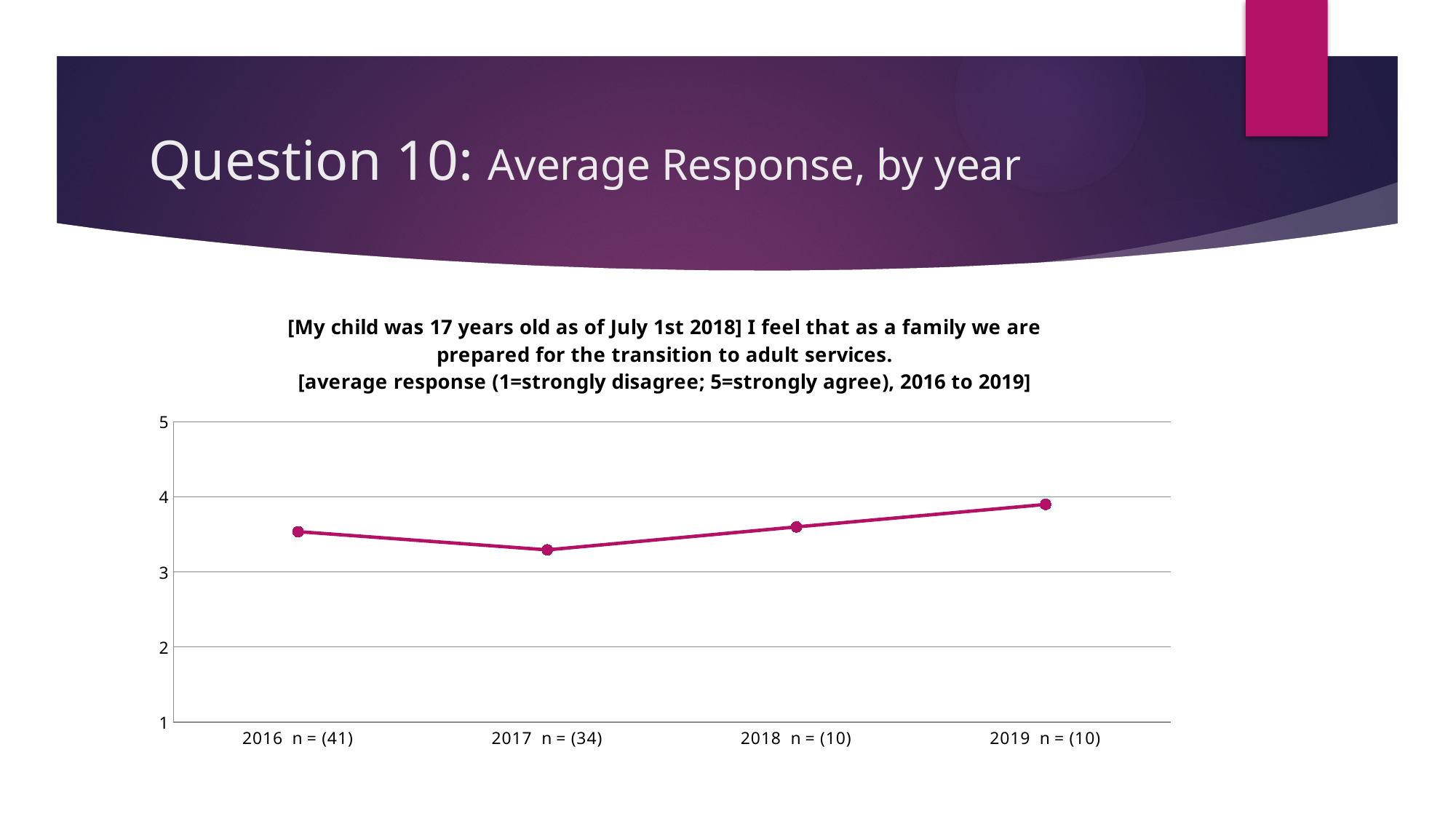
What response scale does the chart title say is used (1 and 5 meanings)? 1=strongly disagree; 5=strongly agree Is the average response for 2017 greater or less than 3? greater Is the average response for 2016 greater or less than 3? greater Which year has the larger average response, 2016 or 2017? 2016 Do the average responses rise or fall from 2017 to 2019? rise Which year has the larger average response, 2017 or 2019? 2019 How many years (data points) are plotted on the chart? 4 Which year has the lowest average response? 2017 What is the sample size (n) shown for 2016? 41 What kind of chart is shown on the slide? line chart Is the average response for 2019 greater or less than 4? less Which year has the highest average response? 2019